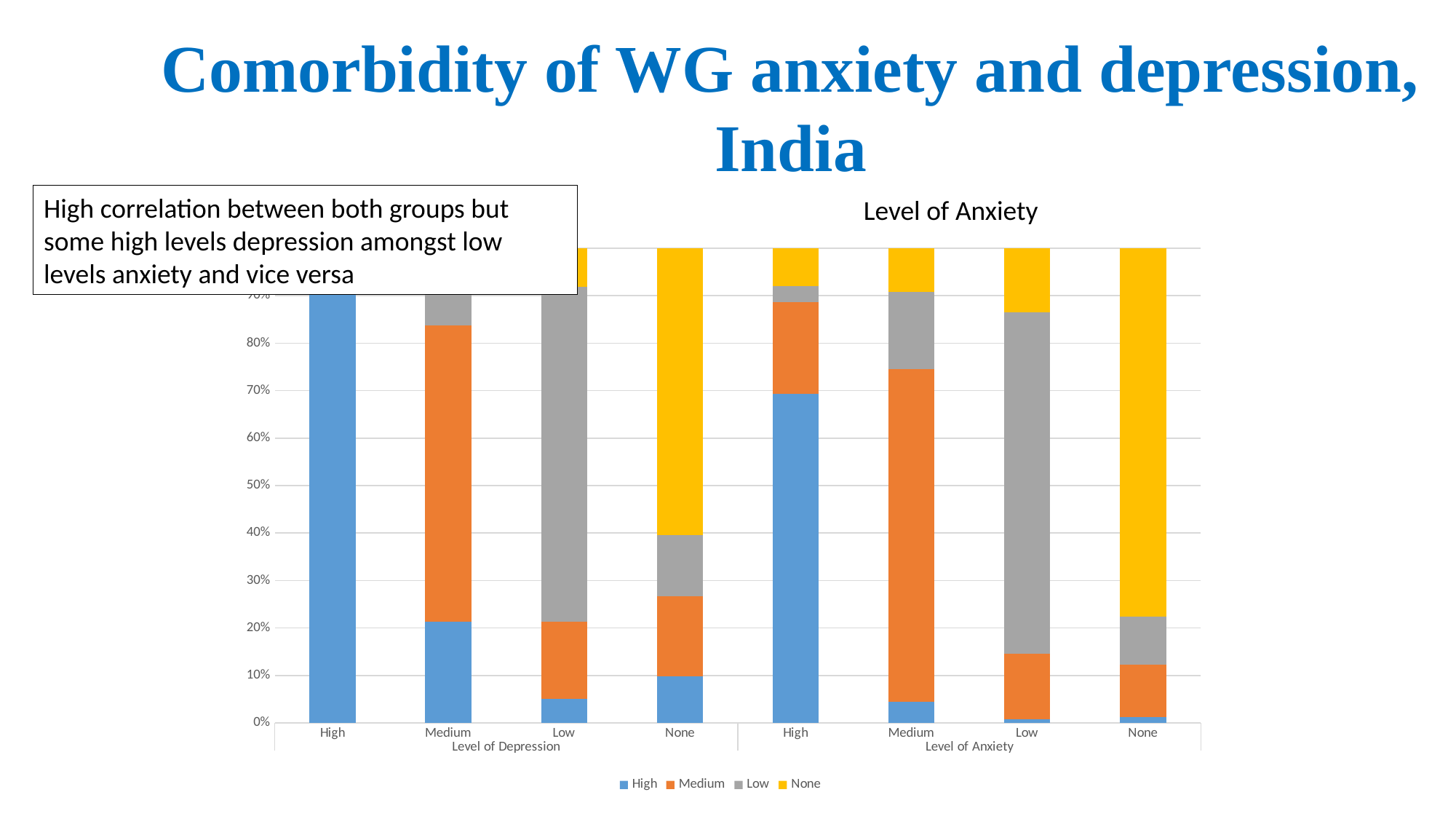
Within the Level of Depression group, which category has the largest 'High' segment? High How many bars are plotted in the chart? 8 Which colour represents the 'None' series in the legend? Yellow What is the title of the chart? Level of Anxiety Which is larger: the 'High' segment of the High bar in the Level of Depression group or the 'High' segment of the High bar in the Level of Anxiety group? Level of Depression High bar Is the 'High' segment of the Medium bar in the Level of Anxiety group greater or less than 10%? less Is the 'None' segment of the None bar in the Level of Anxiety group greater or less than 70%? greater Is the 'Medium' segment of the Medium bar in the Level of Depression group greater or less than 50%? greater What kind of chart is shown on the slide? Stacked bar chart How many series does the legend list? 4